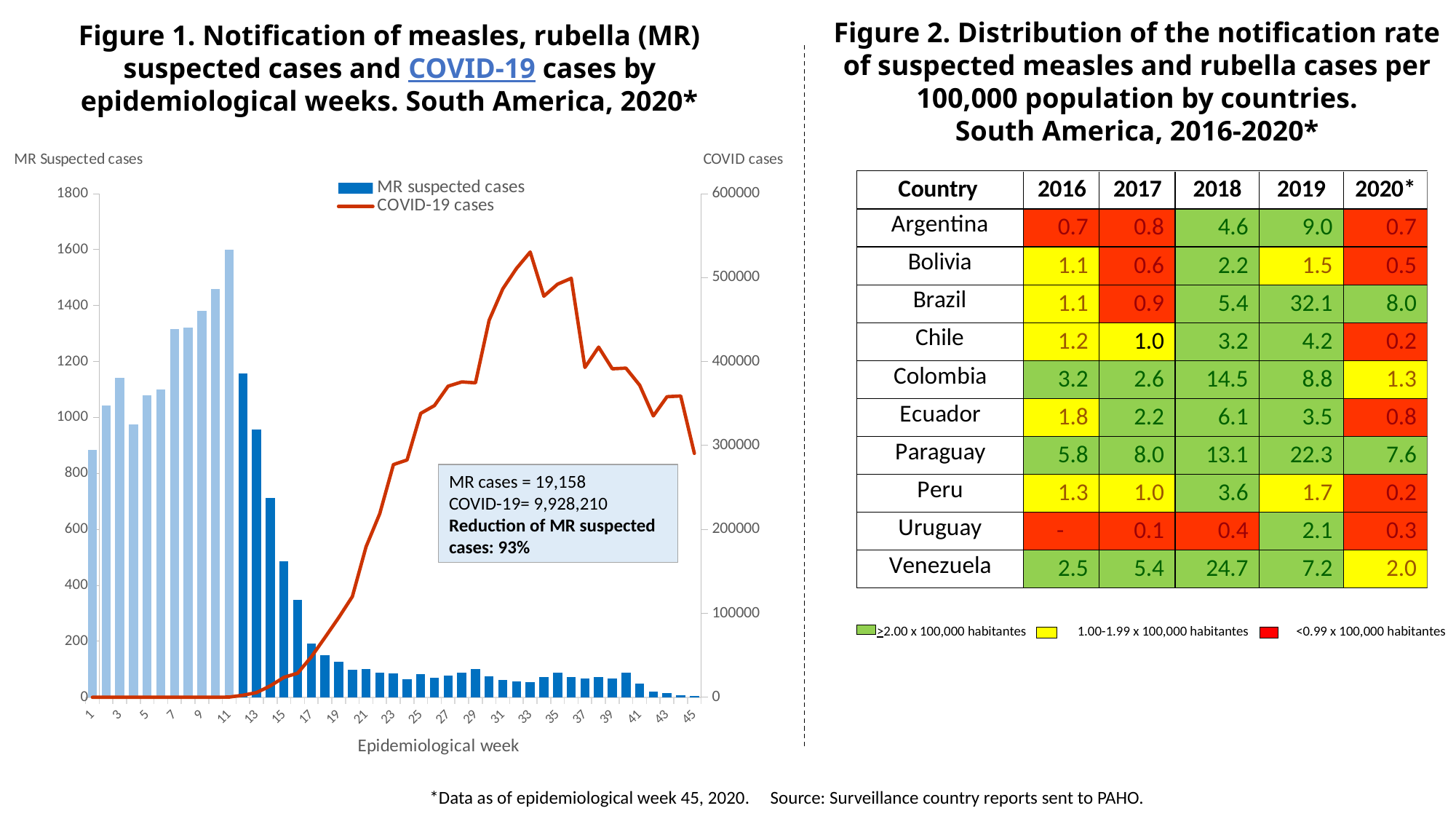
In Figure 1, which week has more MR suspected cases, week 1 or week 11? Week 11 In Figure 1, is the number of MR suspected cases in week 13 greater or less than 1000? less In Figure 1, do the MR suspected cases rise or fall from week 11 to week 17? Fall In Figure 1, is the number of MR suspected cases in week 15 greater or less than 600? less In Figure 1, what is the label of the x axis? Epidemiological week In Figure 1, how many epidemiological weeks are plotted on the x axis? 45 In Figure 1, how many series does the legend list? 2 In Figure 1, is the number of MR suspected cases in week 11 greater or less than 1400? greater In Figure 1, do the COVID-19 cases rise or fall from week 17 to week 33? Rise In Figure 1, which epidemiological week has the highest number of MR suspected cases? Week 11 In Figure 1, what total number of MR cases is stated in the text box? 19,158 In Figure 1, what type of chart is used to show the MR suspected cases? Bar chart